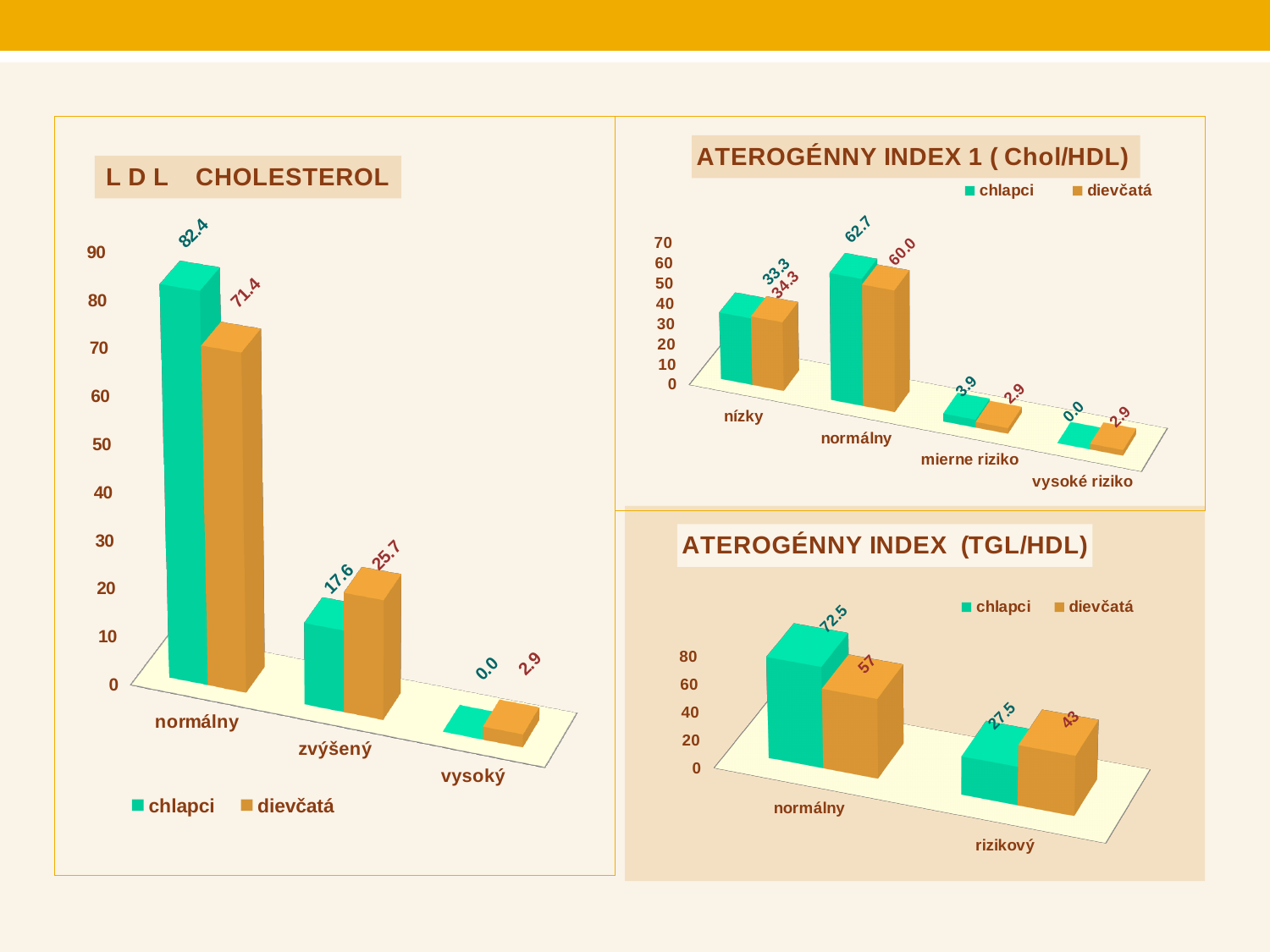
In the L D L CHOLESTEROL chart, how many categories are shown on the x axis? 3 In the L D L CHOLESTEROL chart, what is the value for dievčatá in the zvýšený category? 25.7 In the ATEROGÉNNY INDEX (TGL/HDL) chart, what is the difference between the dievčatá and chlapci values in the rizikový category? 15.5 In the L D L CHOLESTEROL chart, what is the value for chlapci in the normálny category? 82.4 In the ATEROGÉNNY INDEX (TGL/HDL) chart, what is the value for dievčatá in the rizikový category? 43 In the ATEROGÉNNY INDEX 1 (Chol/HDL) chart, how many series does the legend list? 2 In the ATEROGÉNNY INDEX 1 (Chol/HDL) chart, which category has the highest value for chlapci? normálny In the ATEROGÉNNY INDEX (TGL/HDL) chart, which is larger in the normálny category, chlapci or dievčatá? chlapci In the L D L CHOLESTEROL chart, what is the difference between the chlapci and dievčatá values in the normálny category? 11.0 What type of chart is the ATEROGÉNNY INDEX (TGL/HDL) chart? bar chart In the ATEROGÉNNY INDEX 1 (Chol/HDL) chart, what is the value for chlapci in the vysoké riziko category? 0.0 In the ATEROGÉNNY INDEX 1 (Chol/HDL) chart, what is the value for dievčatá in the nízky category? 34.3